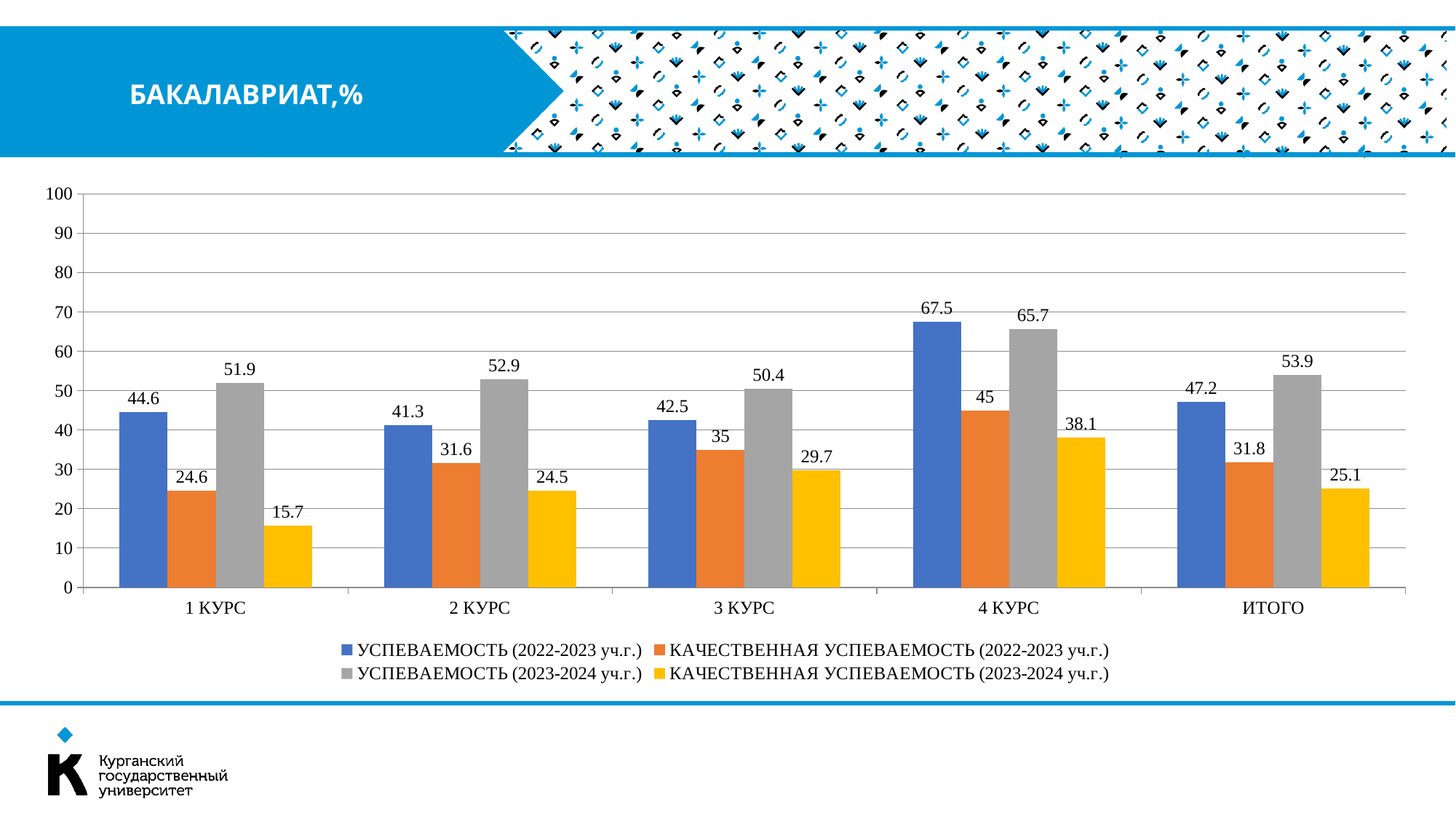
Which category has the highest value for УСПЕВАЕМОСТЬ (2022-2023 уч.г.)? 4 КУРС How many categories are shown on the x axis? 5 What is the value of УСПЕВАЕМОСТЬ (2023-2024 уч.г.) for ИТОГО? 53.9 What is the value of УСПЕВАЕМОСТЬ (2022-2023 уч.г.) for 1 КУРС? 44.6 What is the title of the slide? БАКАЛАВРИАТ,% Which is larger for 3 КУРС: КАЧЕСТВЕННАЯ УСПЕВАЕМОСТЬ (2022-2023 уч.г.) or КАЧЕСТВЕННАЯ УСПЕВАЕМОСТЬ (2023-2024 уч.г.)? КАЧЕСТВЕННАЯ УСПЕВАЕМОСТЬ (2022-2023 уч.г.) What is the difference between УСПЕВАЕМОСТЬ (2023-2024 уч.г.) and УСПЕВАЕМОСТЬ (2022-2023 уч.г.) for 2 КУРС? 11.6 What kind of chart is shown on the slide? bar chart How many series does the legend list? 4 Which category has the lowest value for КАЧЕСТВЕННАЯ УСПЕВАЕМОСТЬ (2023-2024 уч.г.)? 1 КУРС What is the value of КАЧЕСТВЕННАЯ УСПЕВАЕМОСТЬ (2023-2024 уч.г.) for 4 КУРС? 38.1 Is the value of УСПЕВАЕМОСТЬ (2023-2024 уч.г.) for 4 КУРС greater or less than 60? greater